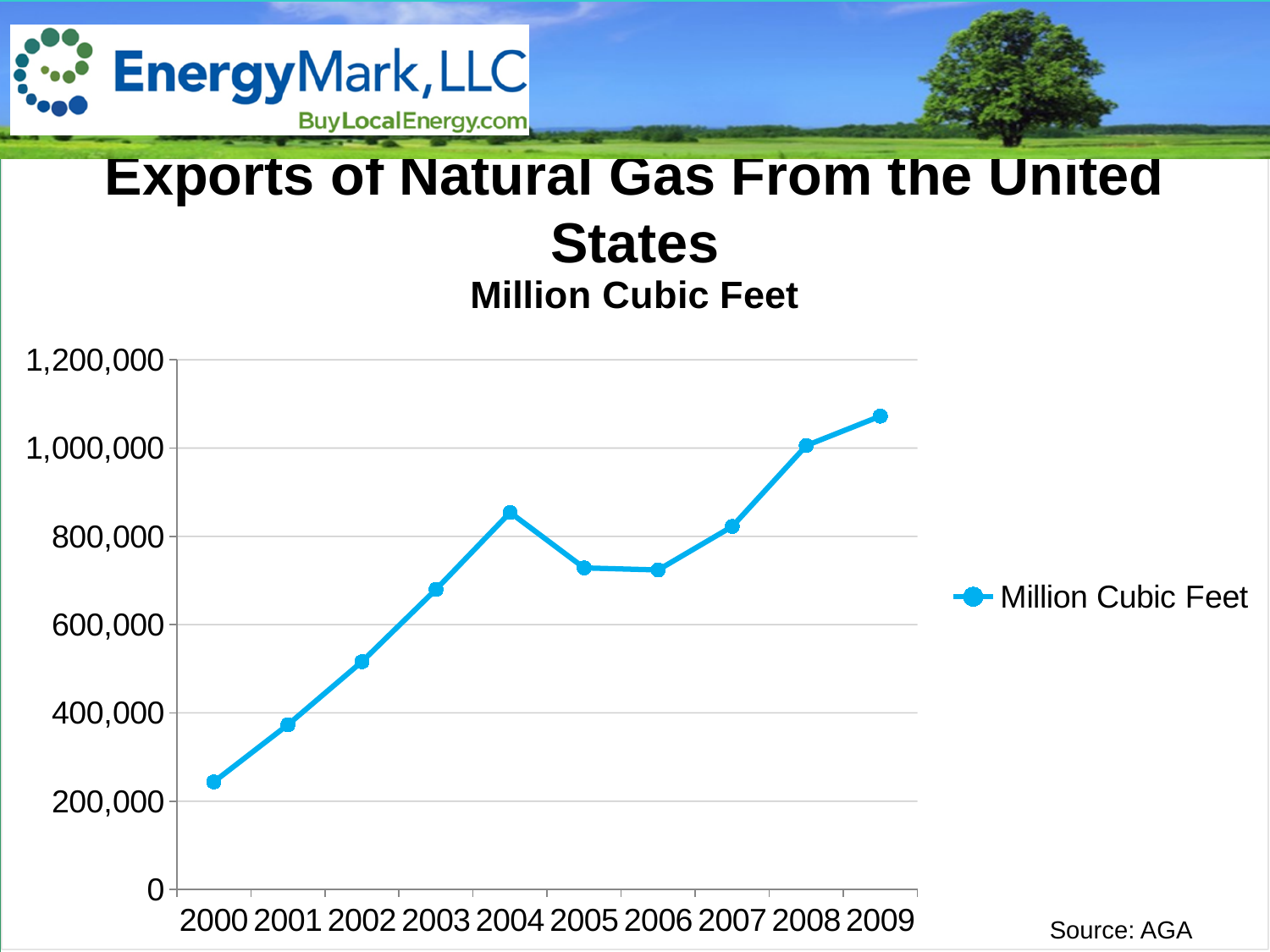
Do the values generally rise or fall from 2000 to 2009? rise Which year has the larger value, 2004 or 2005? 2004 Is the value for 2002 greater or less than 600,000? less What unit is given in the chart's subtitle? Million Cubic Feet What kind of chart is shown on the slide? line chart Which year has the larger value, 2003 or 2007? 2007 Which year has the lowest value for exports of natural gas? 2000 How many series does the legend list? 1 Is the value for 2009 greater or less than 1,000,000? greater Which year has the highest value for exports of natural gas? 2009 Is the value for 2006 greater or less than 800,000? less How many years are plotted on the x axis? 10